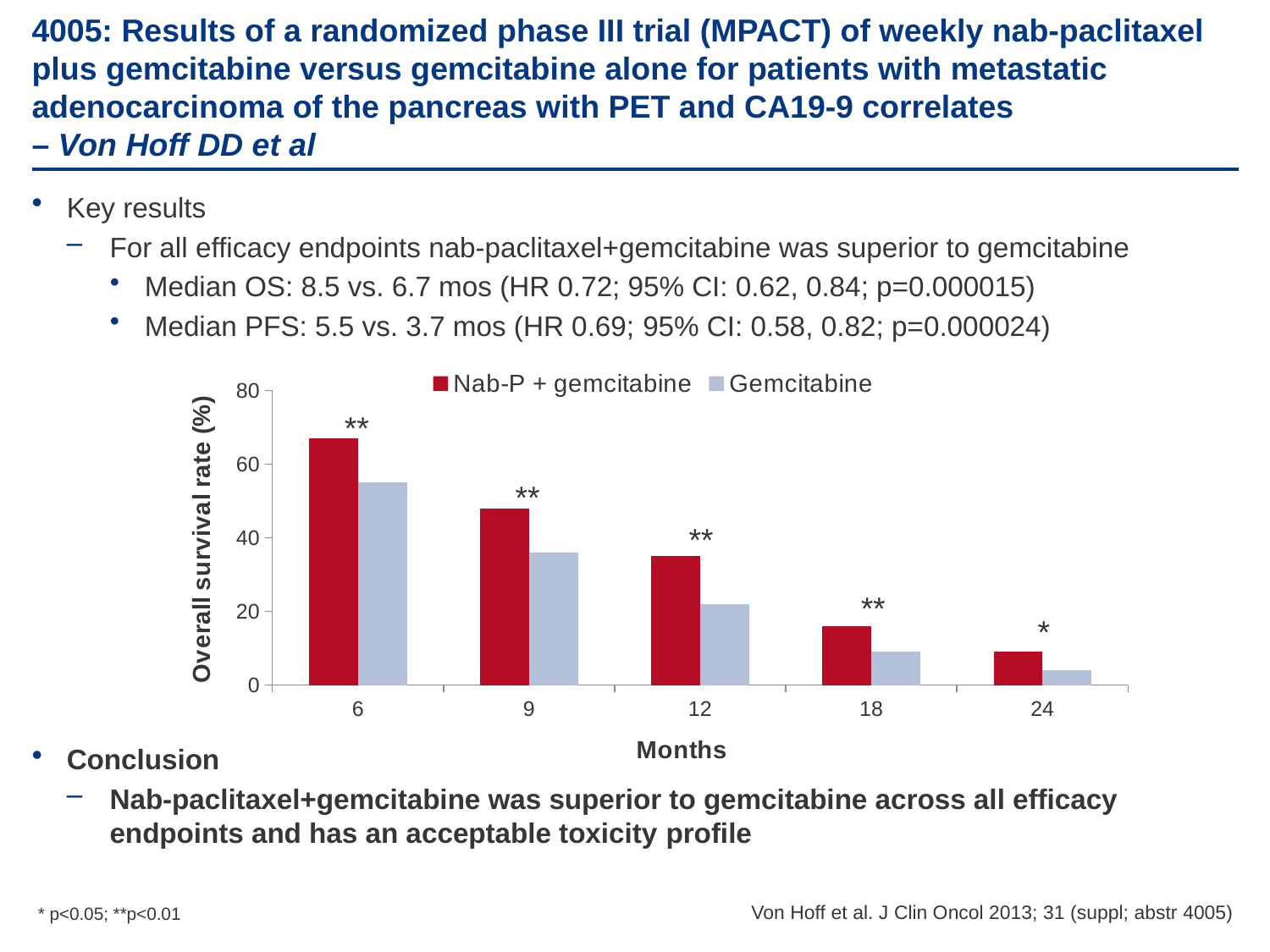
Is the overall survival rate for Nab-P + gemcitabine at 6 months greater or less than 60? greater At which month is the overall survival rate for Gemcitabine lowest? 24 At 12 months, which series has the higher overall survival rate, Nab-P + gemcitabine or Gemcitabine? Nab-P + gemcitabine Is the overall survival rate for Gemcitabine at 24 months greater or less than 20? less Do the overall survival rates rise or fall as the months increase along the x axis? fall Is the overall survival rate for Nab-P + gemcitabine at 9 months greater or less than 40? greater What kind of chart is shown on the slide? bar chart How many time points (months) are shown on the x axis of the chart? 5 At which month is the overall survival rate for Nab-P + gemcitabine highest? 6 How many series does the chart legend list? 2